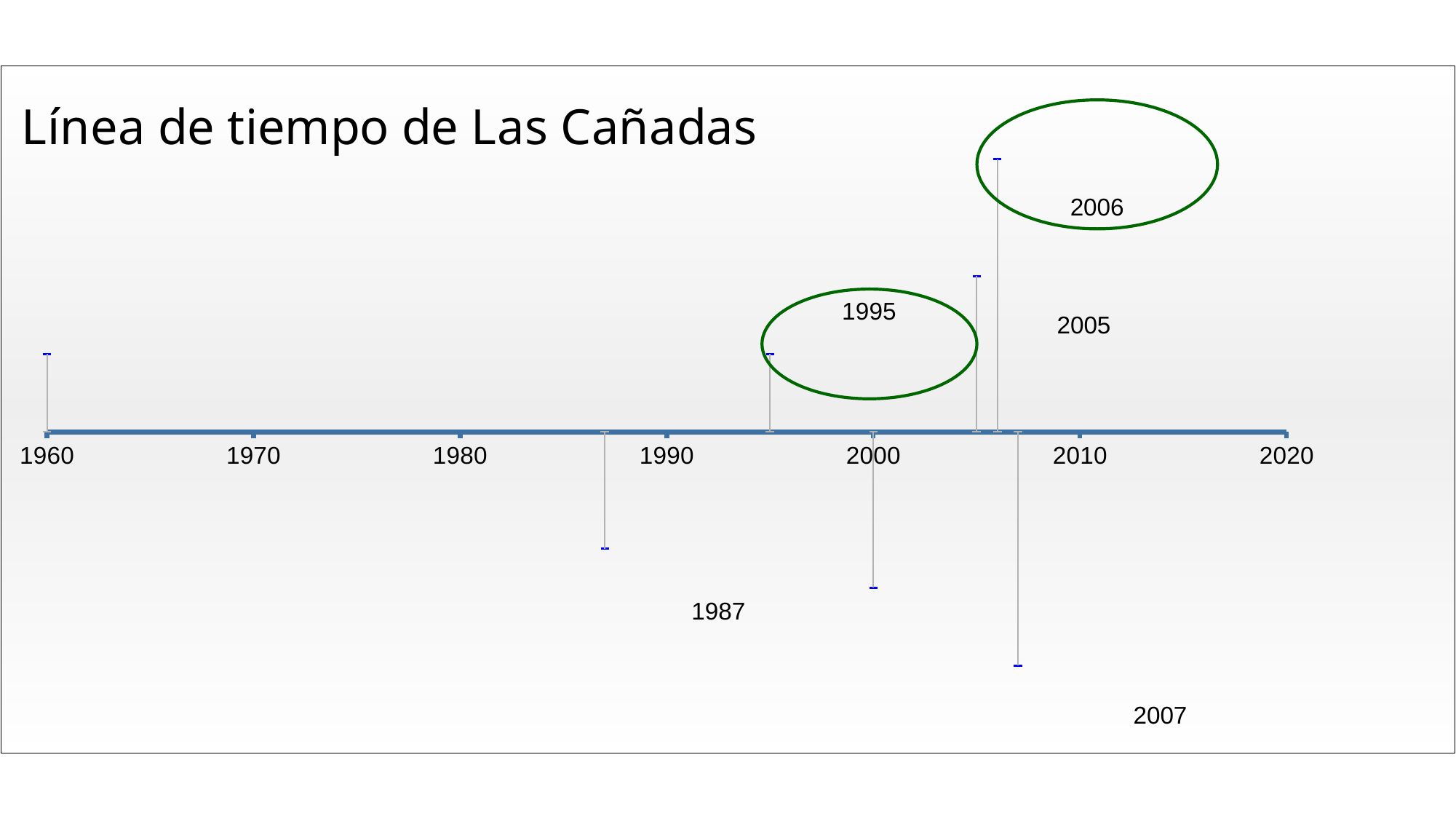
How many years separate the events labelled 1987 and 2007? 20 What is the first year shown on the timeline axis? 1960 What is the title of the chart on the slide? Línea de tiempo de Las Cañadas What is the earliest labelled event year on the timeline? 1987 Which event is later on the timeline, 1995 or 2006? 2006 What is the last year shown on the timeline axis? 2020 Is the event labelled 1987 plotted before or after the 1990 tick on the axis? before How many event markers are plotted on the timeline? 7 How many year ticks are labelled along the timeline axis? 7 Which two years on the timeline are circled in green? 1995 and 2006 What is the latest labelled event year on the timeline? 2007 What kind of chart is shown on the slide? Timeline